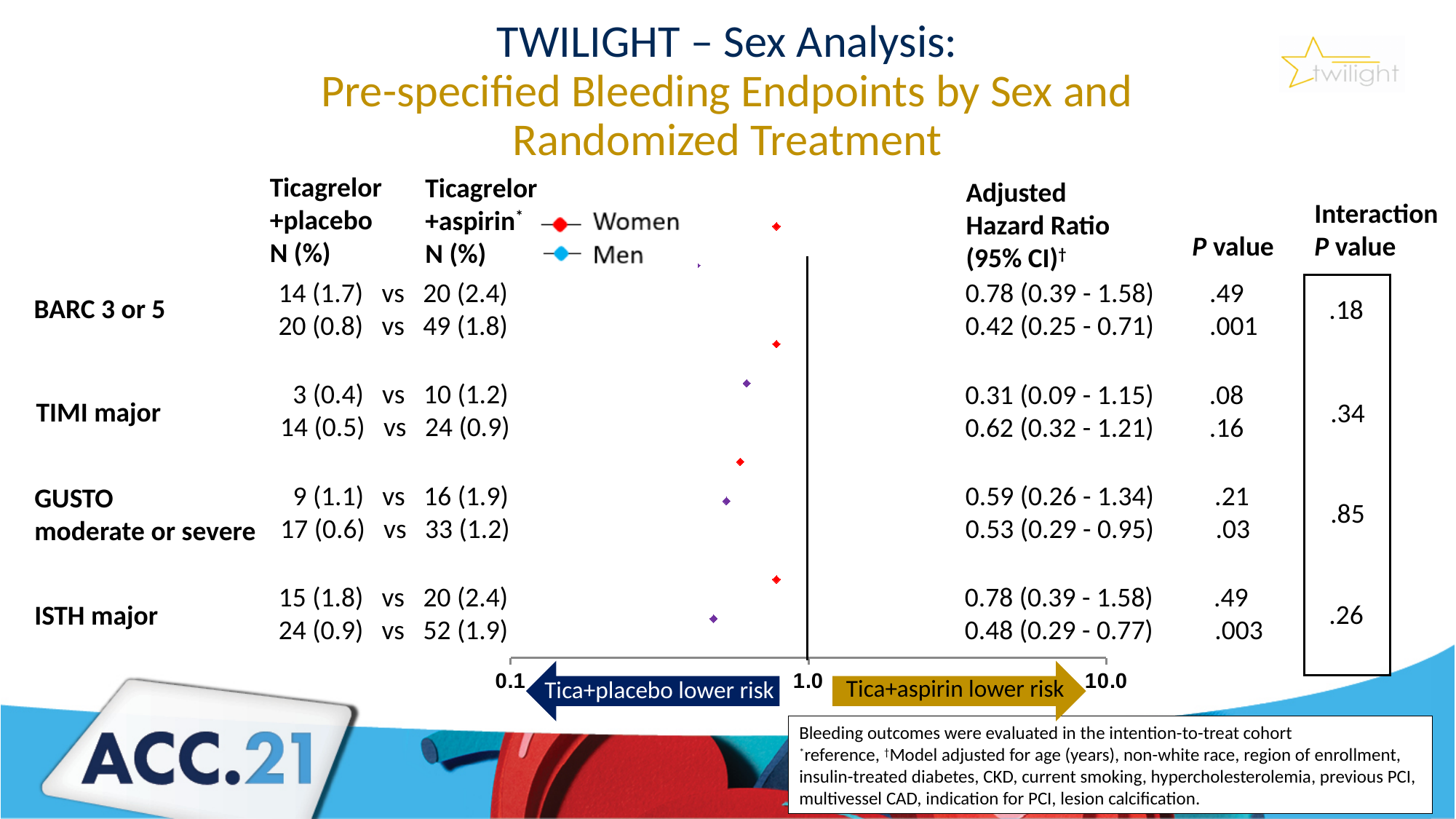
For TIMI major, is the adjusted hazard ratio larger for women or for men? Men What is the adjusted hazard ratio (95% CI) for women for BARC 3 or 5 bleeding? 0.78 (0.39 - 1.58) What is the adjusted hazard ratio (95% CI) for men for BARC 3 or 5 bleeding? 0.42 (0.25 - 0.71) Among men, which bleeding endpoint has the highest adjusted hazard ratio? TIMI major (0.62) Which endpoint and sex has the lowest adjusted hazard ratio on the plot? TIMI major, women (0.31) How many bleeding endpoints are shown on the forest plot? 4 What is the difference between the adjusted hazard ratios for women and men for BARC 3 or 5? 0.36 Which colour represents Women in the forest plot legend? Red How many series does the legend of the forest plot list? 2 Is the adjusted hazard ratio for men for ISTH major greater or less than 1.0? less What kind of chart is shown on the slide? Forest plot What is the interaction P value for GUSTO moderate or severe bleeding? .85